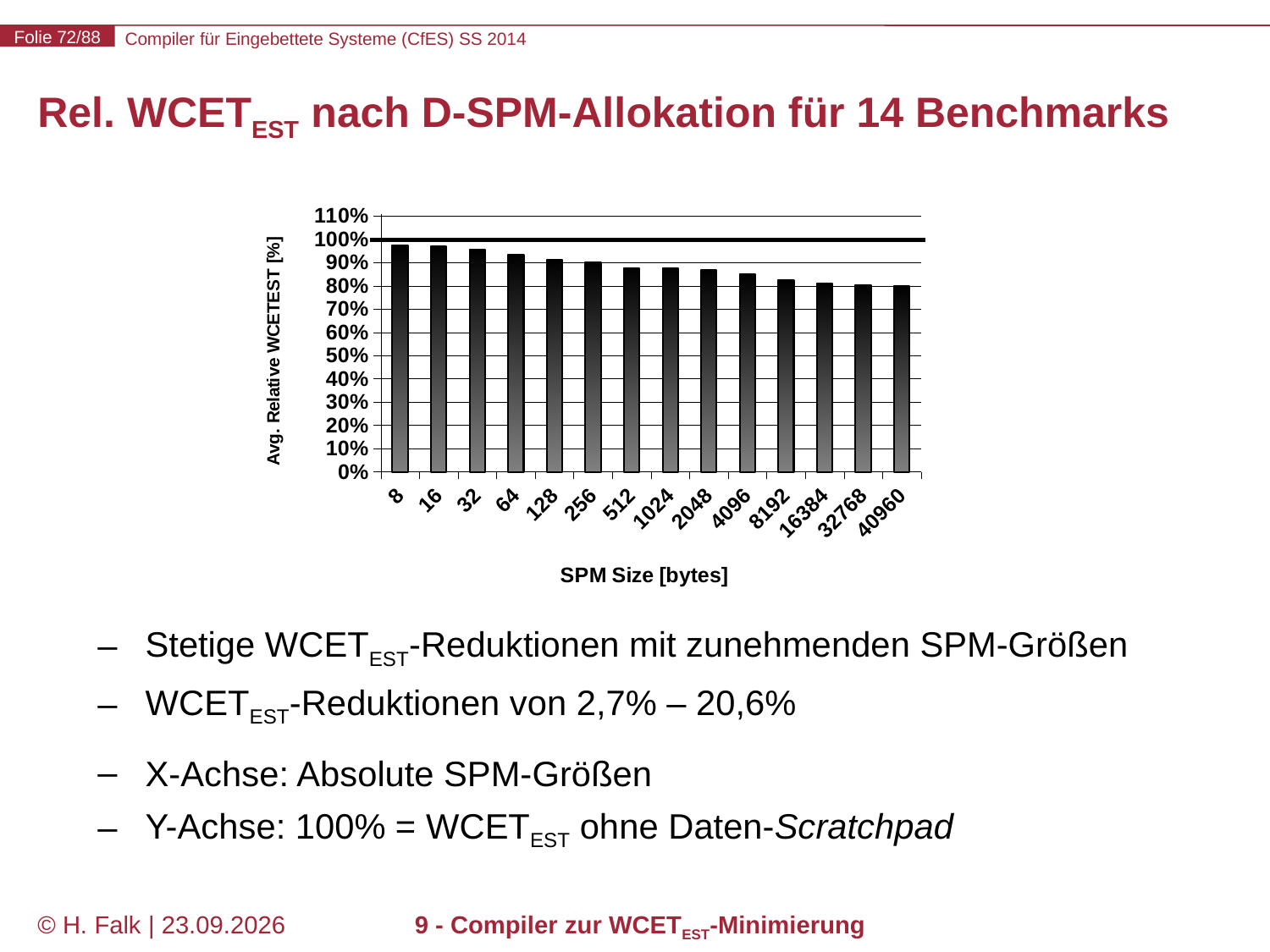
Is the value for SPM size 4096 greater or less than 90%? less Which has the larger value, SPM size 64 or SPM size 8192? 64 Which has the larger value, SPM size 8 or SPM size 40960? 8 What kind of chart is shown on the slide? bar chart How many SPM sizes are shown on the x axis of the chart? 14 What is the title of the x axis of the chart? SPM Size [bytes] Is the value for SPM size 8 greater or less than 90%? greater Is the value for SPM size 40960 greater or less than 90%? less Do the bar values rise or fall as the SPM size increases along the x axis? fall What is the highest tick label shown on the y axis of the chart? 110%